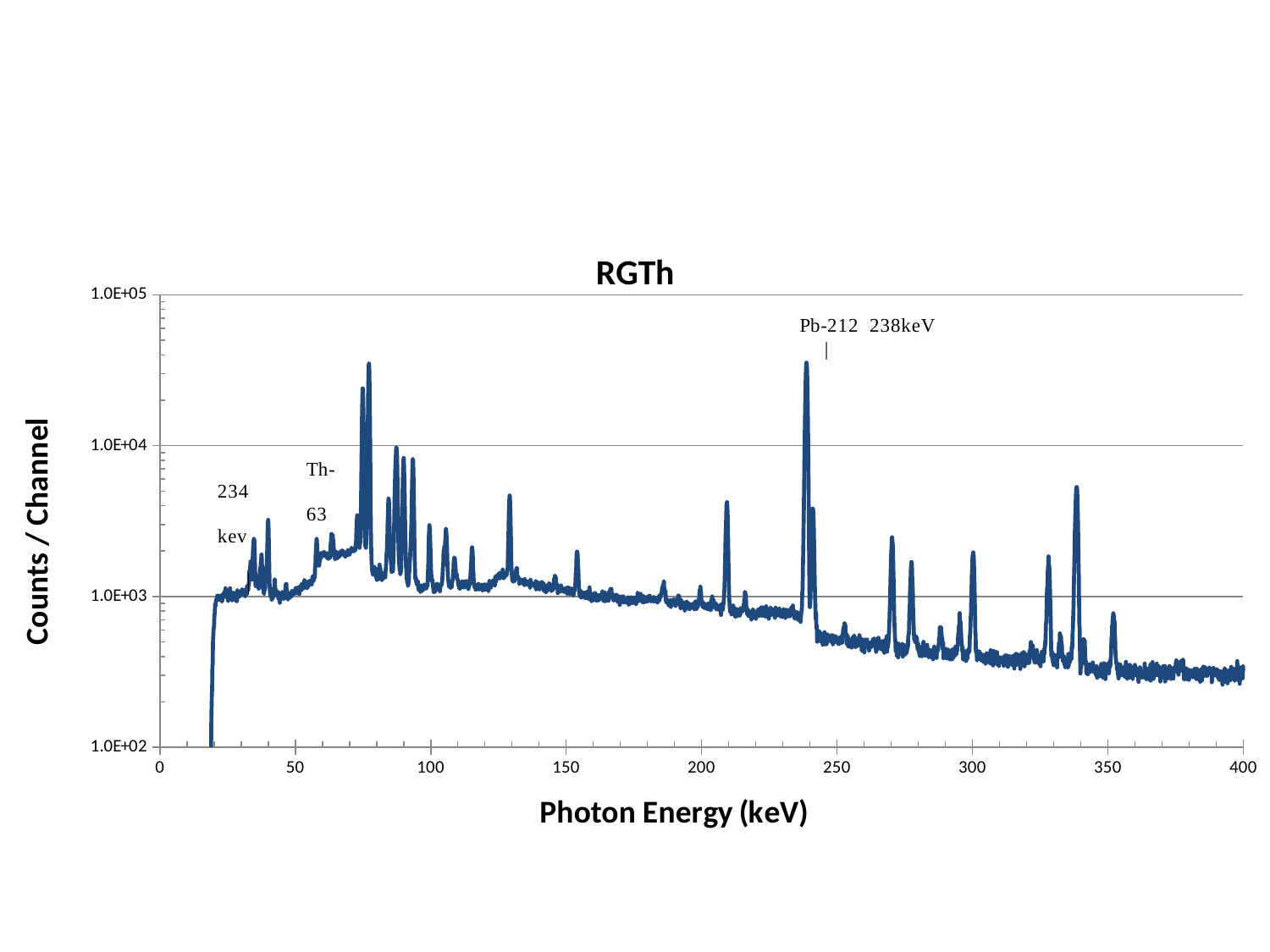
What is the label of the x axis? Photon Energy (keV) Which is larger: the peak near 338 keV or the peak near 300 keV? the peak near 338 keV Is the value at 400 keV greater or less than 1.0E+03 counts per channel? less Which isotope and energy are annotated at the tall peak near 238 keV? Pb-212 238keV Is the value at the Pb-212 peak near 238 keV greater or less than 1.0E+04 counts per channel? greater Which is larger: the peak near 238 keV or the peak near 300 keV? the peak near 238 keV Is the value at the peak near 300 keV greater or less than 1.0E+03 counts per channel? greater What type of chart is shown on the slide? line chart What is the title of the chart? RGTh Does the baseline of the spectrum rise or fall between 250 keV and 400 keV? fall